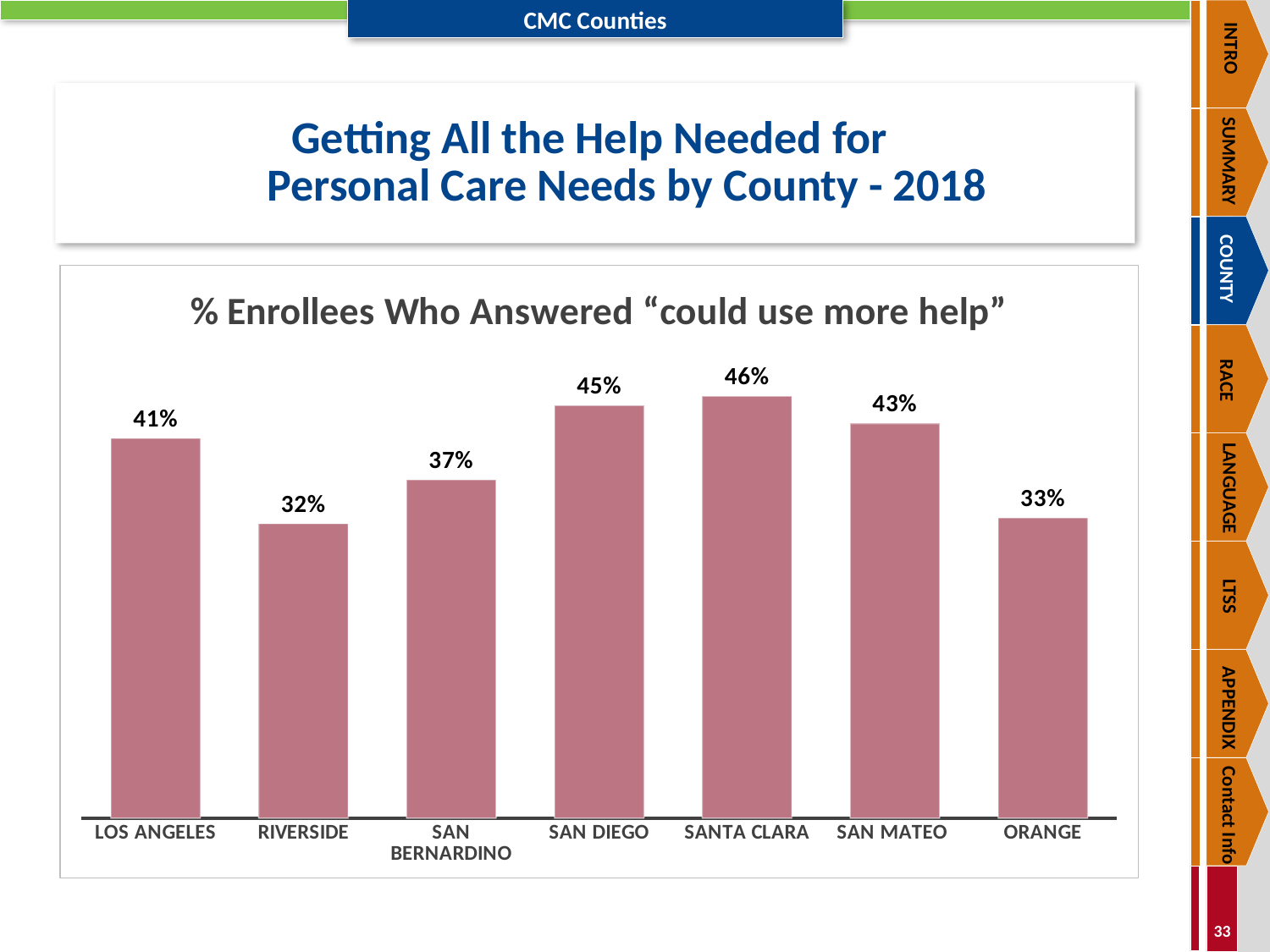
What is the value shown for Orange? 33% What percentage of enrollees in Los Angeles answered "could use more help"? 41% What is the title of the chart? % Enrollees Who Answered "could use more help" What is the value shown for San Diego? 45% Which county has the highest percentage of enrollees who answered "could use more help"? Santa Clara Which is larger, the value for Orange or the value for San Mateo? San Mateo What kind of chart is shown on the slide? Bar chart How many counties are shown in the chart? 7 What is the difference between the values for Santa Clara and Riverside? 14% What is the difference between the values for San Mateo and San Bernardino? 6% Which county has the lowest percentage of enrollees who answered "could use more help"? Riverside Which is larger, the value for Los Angeles or the value for San Bernardino? Los Angeles